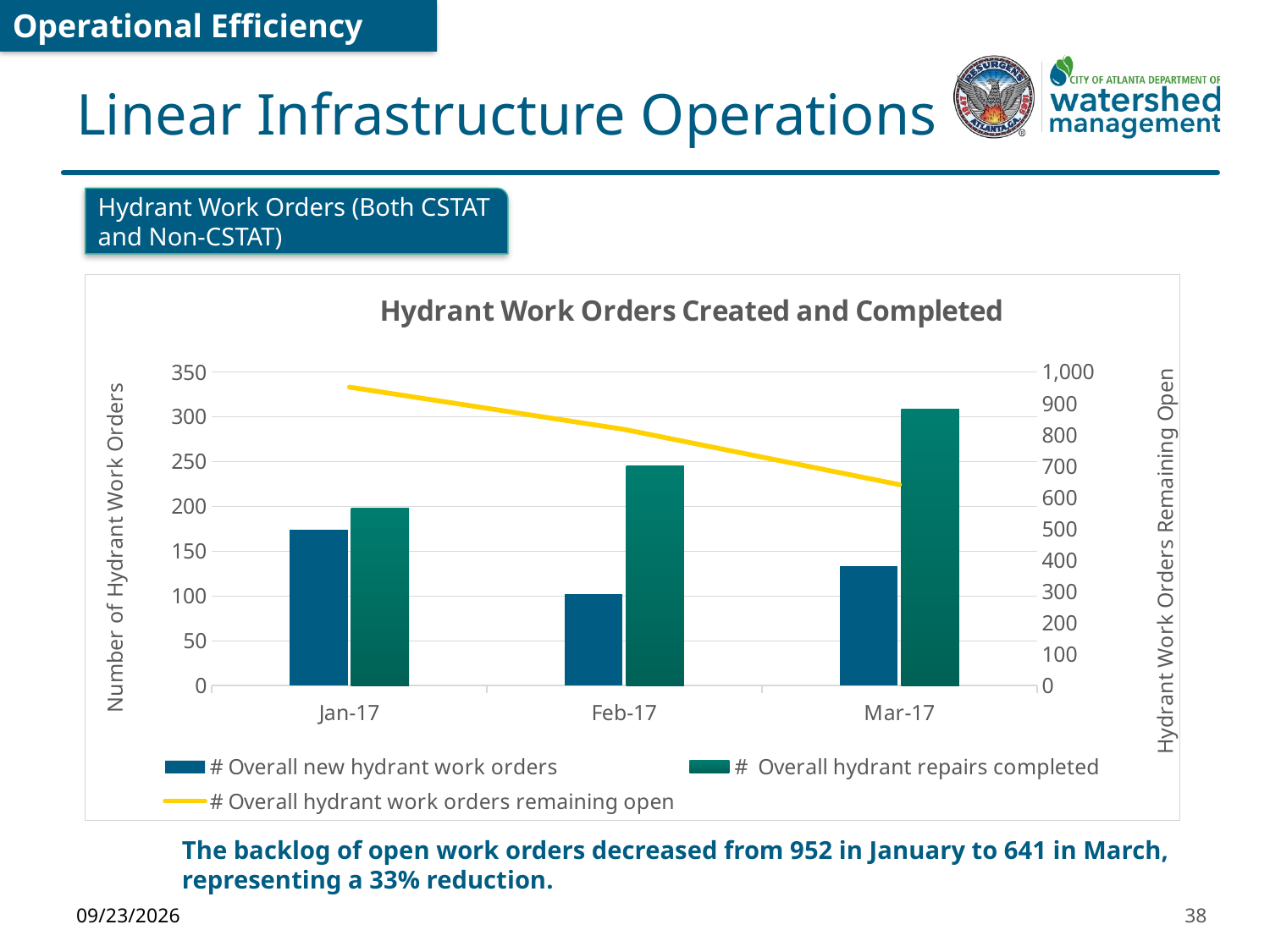
Is the value for overall hydrant repairs completed in Mar-17 greater or less than 250? greater Is the value for overall new hydrant work orders in Mar-17 greater or less than 150? less Is the value for overall new hydrant work orders in Jan-17 greater or less than 150? greater How many months are shown on the x axis of the chart? 3 How many series does the chart legend list? 3 Which month has the lowest number of overall new hydrant work orders? Feb-17 Which month has the highest number of overall hydrant repairs completed? Mar-17 What is the title of the chart? Hydrant Work Orders Created and Completed Does the number of overall hydrant work orders remaining open rise or fall from Jan-17 to Mar-17? fall In Feb-17, which is larger: overall new hydrant work orders or overall hydrant repairs completed? Overall hydrant repairs completed What is the label of the right-hand vertical axis of the chart? Hydrant Work Orders Remaining Open Which month has the highest number of overall new hydrant work orders? Jan-17